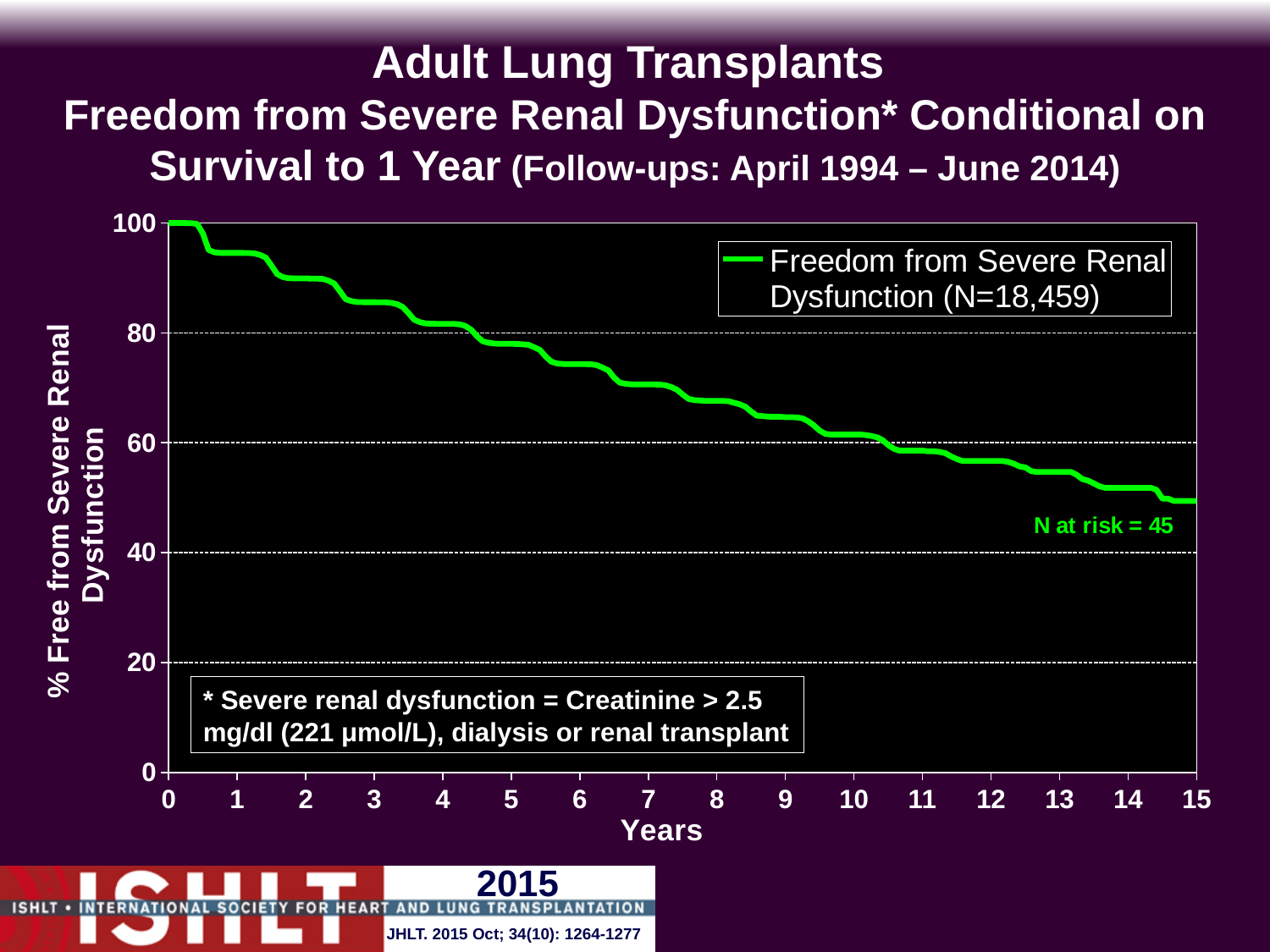
How many series does the legend list? 1 What is the value of the curve at year 0? 100 Does the freedom from severe renal dysfunction curve rise or fall as years increase? fall What is the N given in the legend for the Freedom from Severe Renal Dysfunction series? 18,459 Is the value of the curve at year 8 greater or less than 60? greater What is the highest value shown on the y axis? 100 Is the value of the curve at year 5 greater or less than 60? greater What is the label of the x axis? Years What kind of chart is shown on the slide? line chart What is the N at risk value printed near the end of the curve? 45 Is the value of the curve at year 2 greater or less than 80? greater